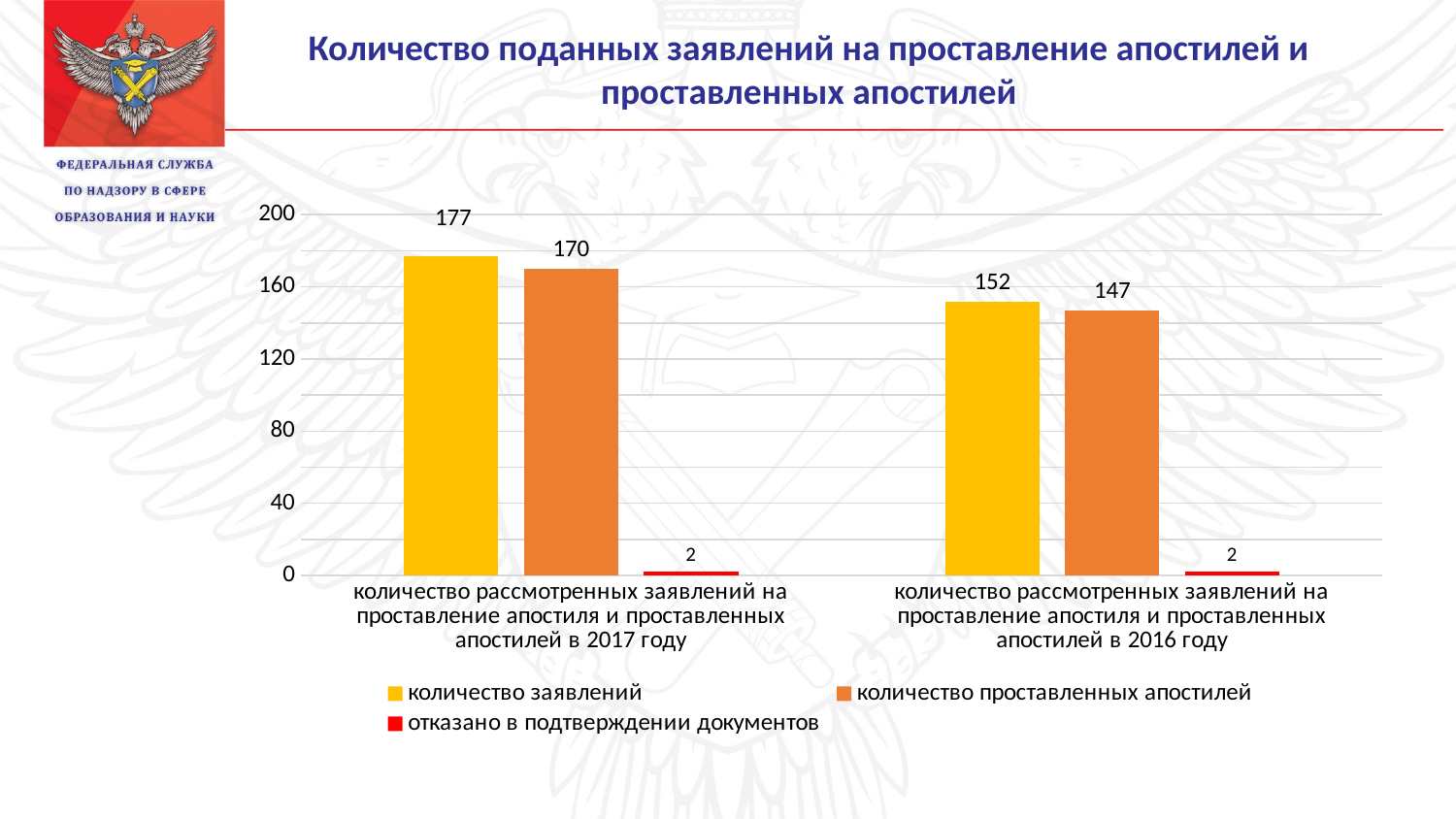
What is the value of 'количество заявлений' for 2017? 177 Which series has the lowest value in 2016? отказано в подтверждении документов What is the value of 'отказано в подтверждении документов' for 2017? 2 What kind of chart is shown on the slide? bar chart Which year has the higher value for 'количество заявлений', 2017 or 2016? 2017 What is the difference between 'количество заявлений' and 'количество проставленных апостилей' in 2017? 7 What is the value of 'количество заявлений' for 2016? 152 What is the value of 'количество проставленных апостилей' for 2016? 147 How many series does the legend list? 3 How many categories are shown on the x axis? 2 What colour represents 'количество проставленных апостилей' in the legend? orange What is the difference between 'количество заявлений' in 2017 and in 2016? 25